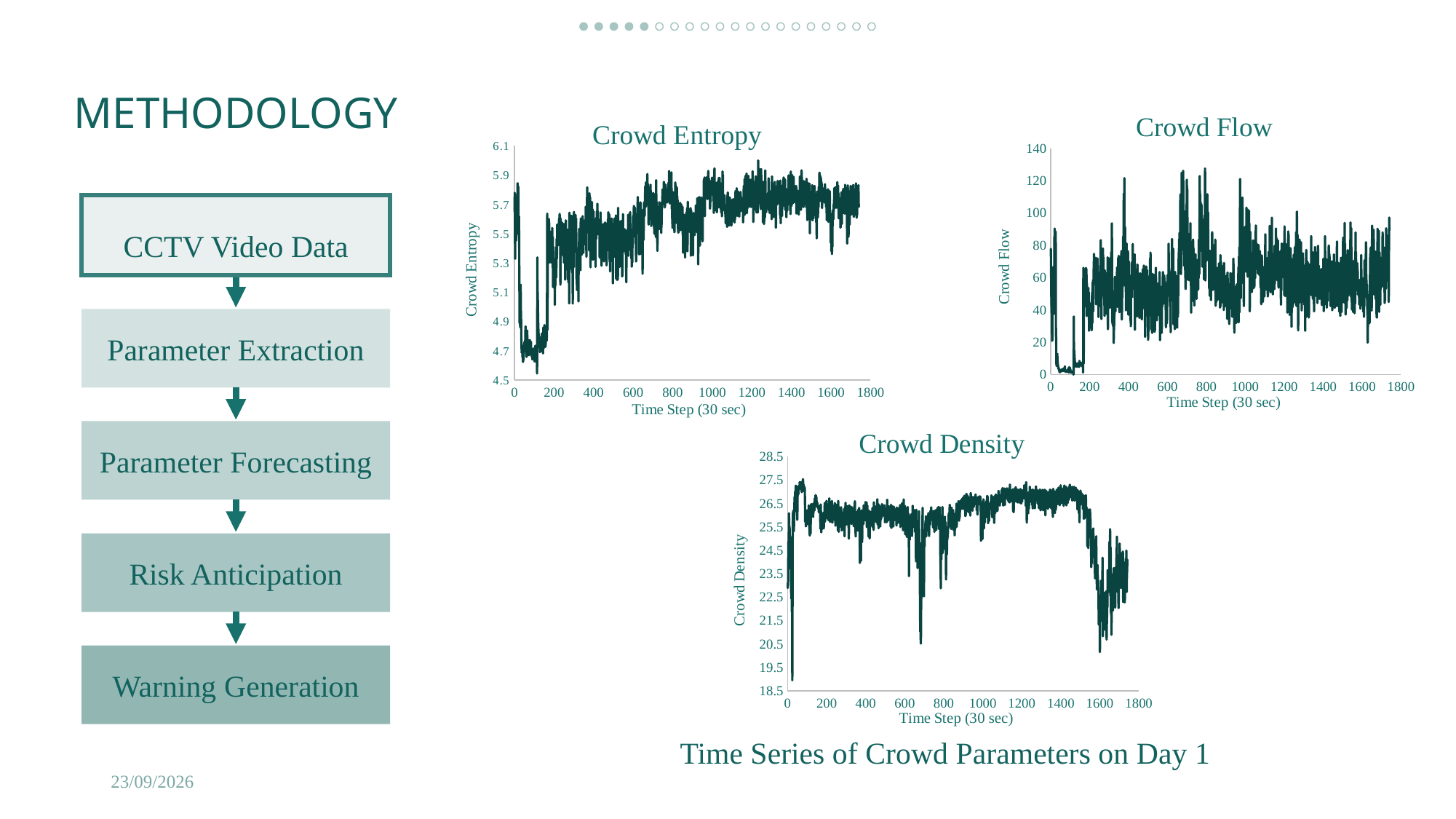
In the Crowd Flow chart, is the value at time step 100 greater or less than 20? less In the Crowd Density chart, is the value at time step 1650 greater or less than 25.5? less How many charts are shown on the slide? 3 In the Crowd Entropy chart, is the value at time step 1200 greater or less than 5.5? greater What is the x-axis label on the Crowd Flow chart? Time Step (30 sec) In the Crowd Entropy chart, do the values overall rise or fall from the start of the series to the end? rise What kind of chart is the Crowd Density chart? line chart What kind of chart is the Crowd Entropy chart? line chart What is the caption shown below the three charts? Time Series of Crowd Parameters on Day 1